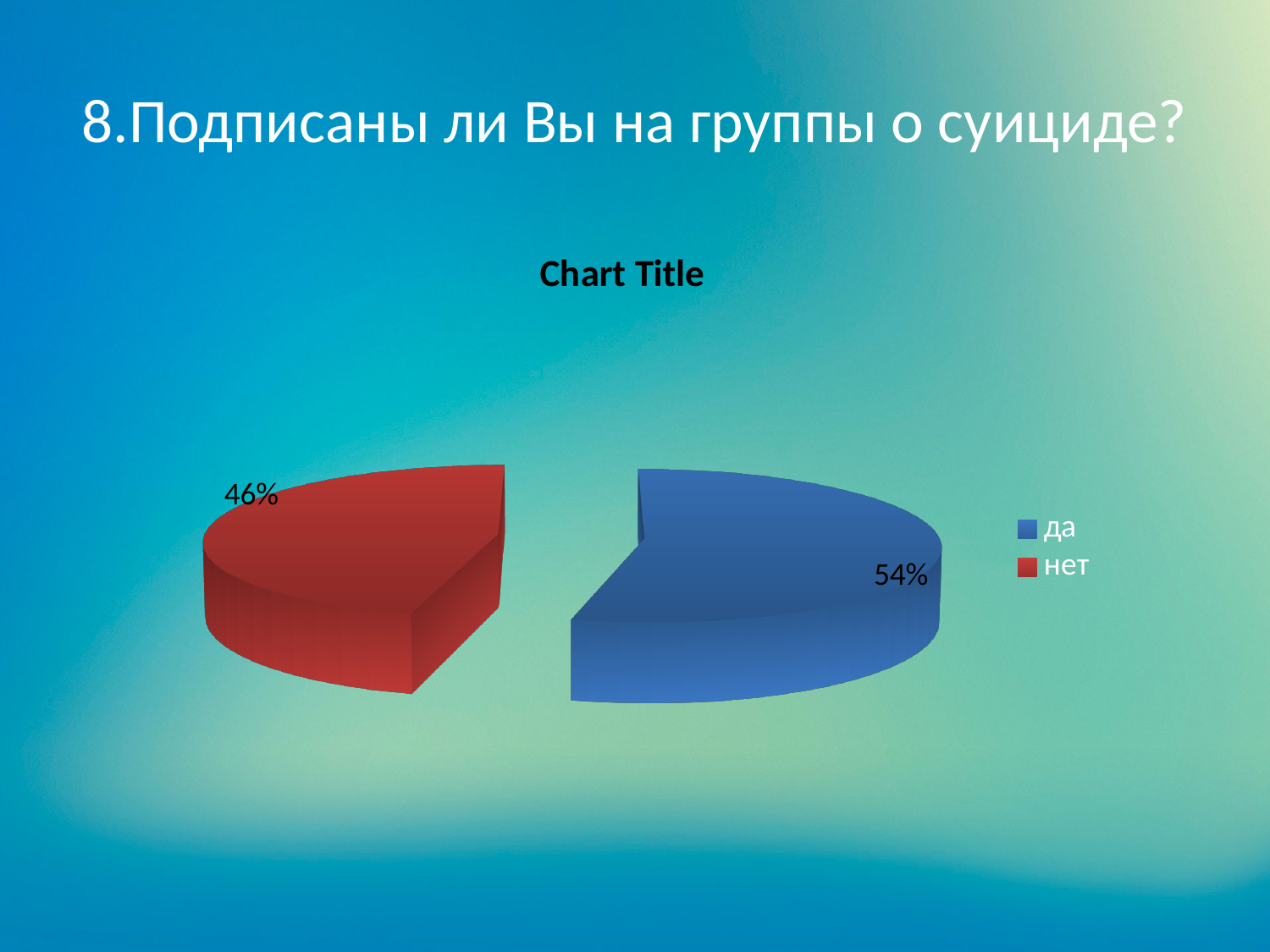
Which category has the largest slice of the pie? да What colour is the "нет" slice? red What is the title shown above the chart? Chart Title What share of the pie does the "нет" slice represent? 46% What kind of chart is shown on the slide? pie chart How many slices does the pie chart have? 2 Is the value for "нет" greater or less than 50%? less What share of the pie does the "да" slice represent? 54% Is the value for "да" greater or less than 50%? greater Which slice is larger, "да" or "нет"? да What is the difference in percentage points between the "да" and "нет" slices? 8 Which category has the smallest slice of the pie? нет